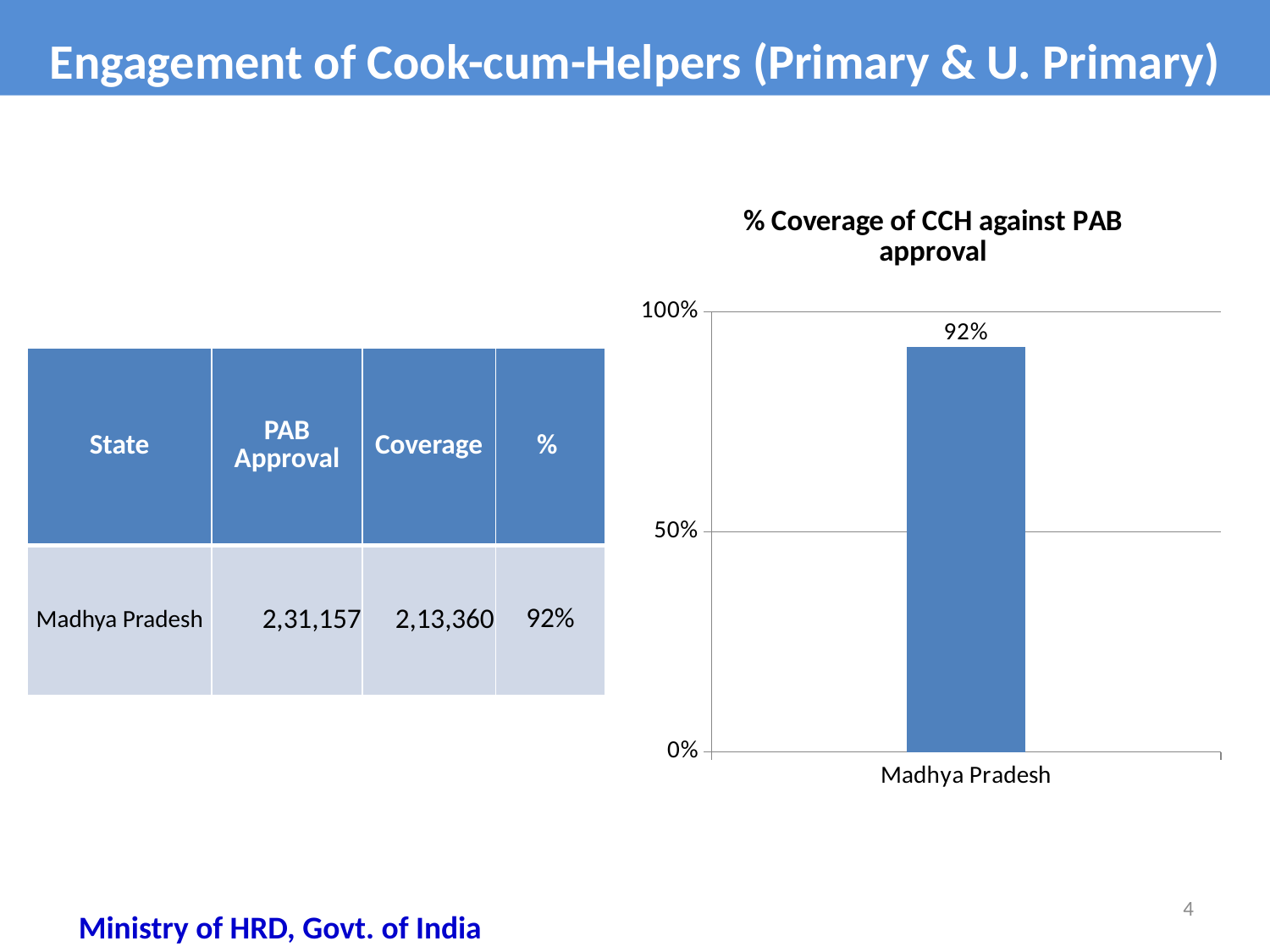
What is the title of the chart? % Coverage of CCH against PAB approval What is the highest value shown on the y axis of the chart? 100% Is the value for Madhya Pradesh greater or less than 100%? less How many categories are plotted in the chart? 1 What is the value shown for Madhya Pradesh in the chart? 92% Is the value for Madhya Pradesh greater or less than 50%? greater What type of chart is shown on the slide? bar chart Which state is shown on the x axis of the chart? Madhya Pradesh